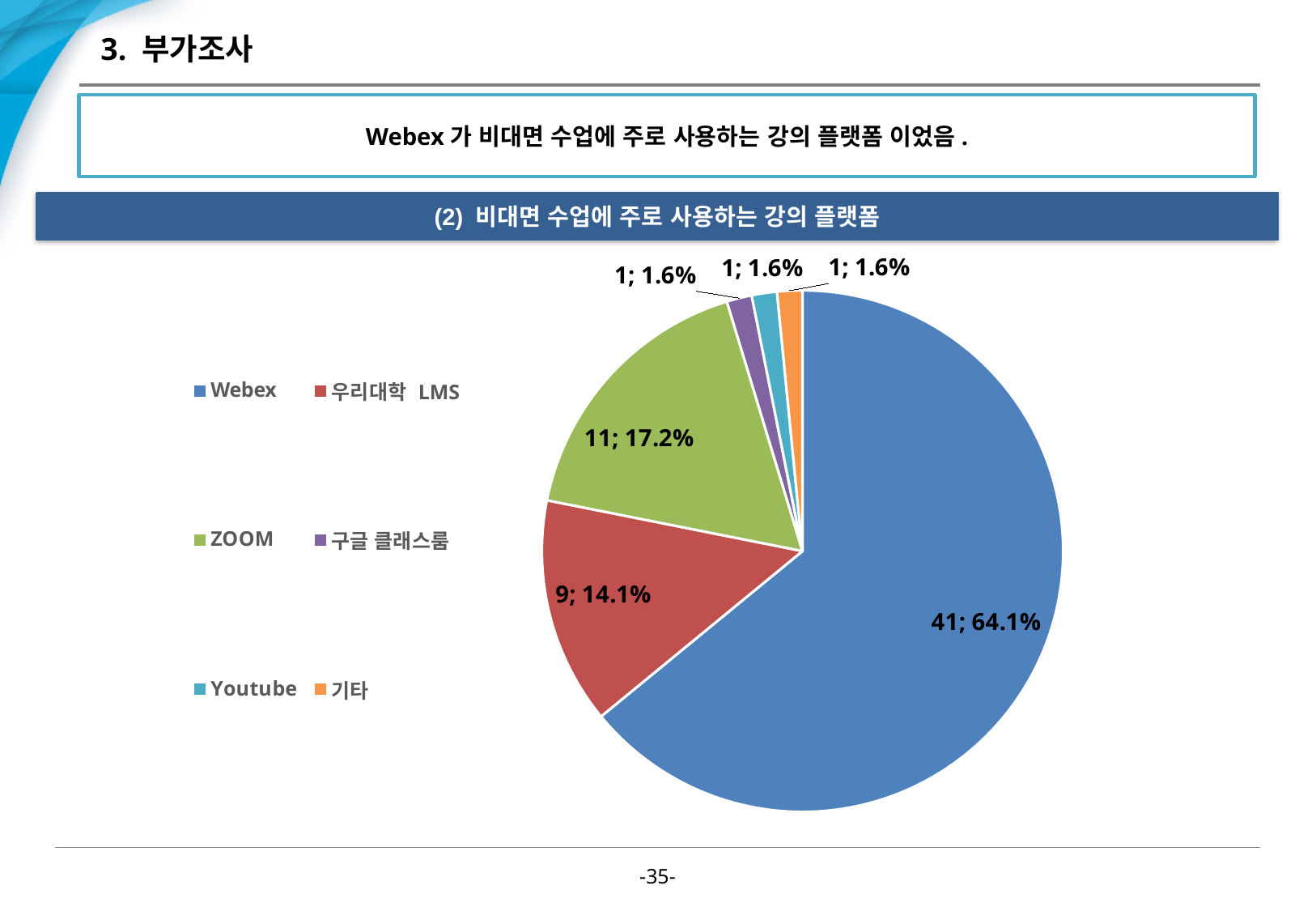
What kind of chart is shown on the slide? pie chart What is the difference in count between Webex and ZOOM in the pie chart? 30 How many categories does the pie chart have? 6 What colour is the Webex slice in the pie chart? blue What is the total count across all slices of the pie chart? 64 What is the count for ZOOM in the pie chart? 11 What percentage share does Webex have in the pie chart? 64.1% Which is larger in the pie chart, ZOOM or 우리대학 LMS? ZOOM What is the difference in count between ZOOM and 우리대학 LMS in the pie chart? 2 Which category has the largest slice in the pie chart? Webex What is the count for Webex in the pie chart? 41 What percentage share does 우리대학 LMS have in the pie chart? 14.1%